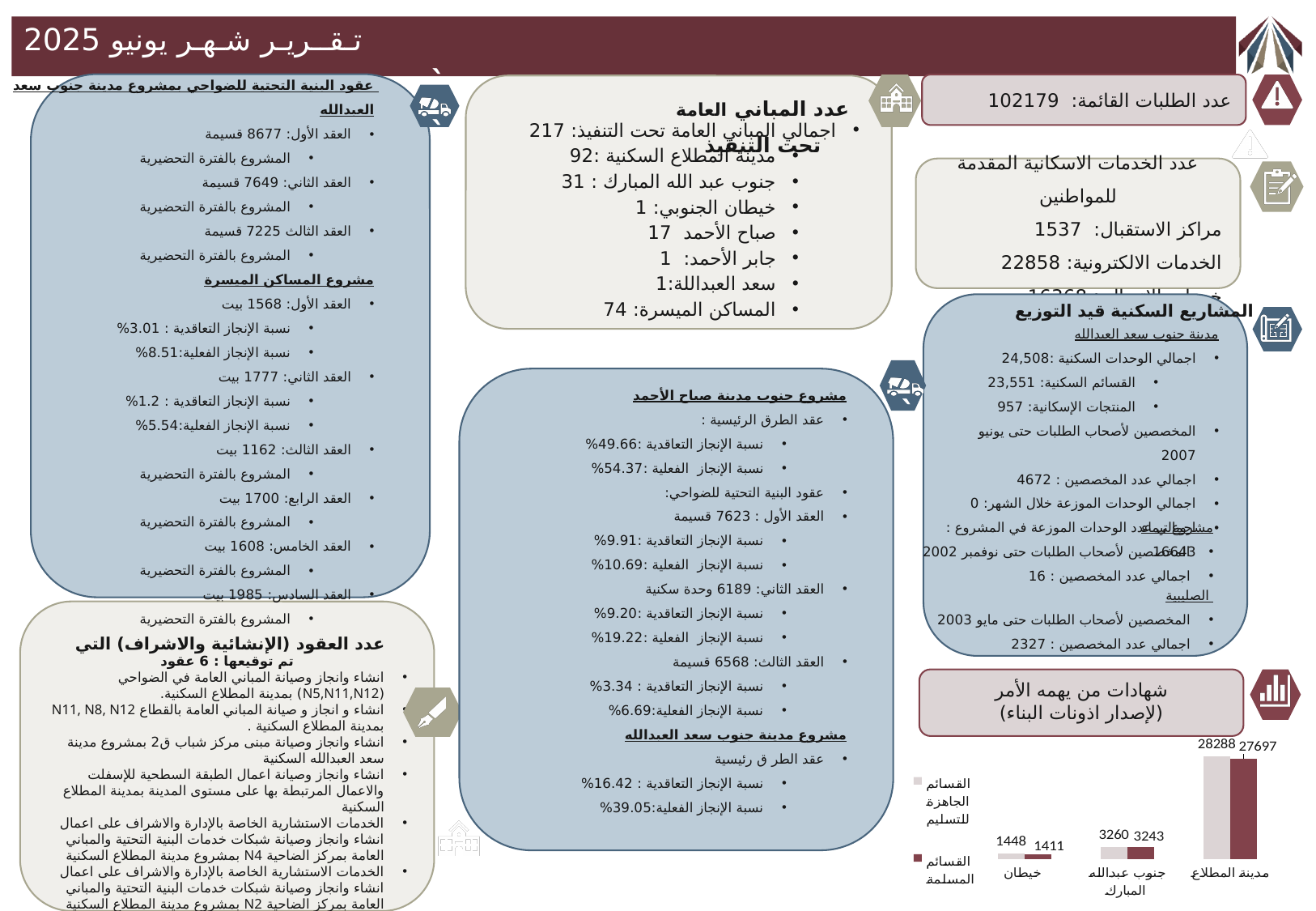
How many categories are shown in the bar chart at the bottom right of the slide? 3 How many series does the legend of the bar chart at the bottom right of the slide list? 2 In the bar chart at the bottom right of the slide, what is the value of القسائم الجاهزة للتسليم for خيطان? 1448 In the bar chart at the bottom right of the slide, what is the value of القسائم الجاهزة للتسليم for مدينة المطلاع? 28288 In the bar chart at the bottom right of the slide, which category has the lowest value for القسائم الجاهزة للتسليم? خيطان In the bar chart at the bottom right of the slide, what is the value of القسائم المسلمة for مدينة المطلاع? 27697 In the bar chart at the bottom right of the slide, what is the value of القسائم المسلمة for جنوب عبدالله المبارك? 3243 In the bar chart at the bottom right of the slide, is the value of القسائم الجاهزة للتسليم for جنوب عبدالله المبارك larger than the value for خيطان? Yes In the bar chart at the bottom right of the slide, what is the difference between القسائم الجاهزة للتسليم and القسائم المسلمة for خيطان? 37 In the bar chart at the bottom right of the slide, what is the difference between القسائم الجاهزة للتسليم and القسائم المسلمة for مدينة المطلاع? 591 In the bar chart at the bottom right of the slide, which category has the highest value for القسائم المسلمة? مدينة المطلاع What kind of chart is shown at the bottom right of the slide? Bar chart